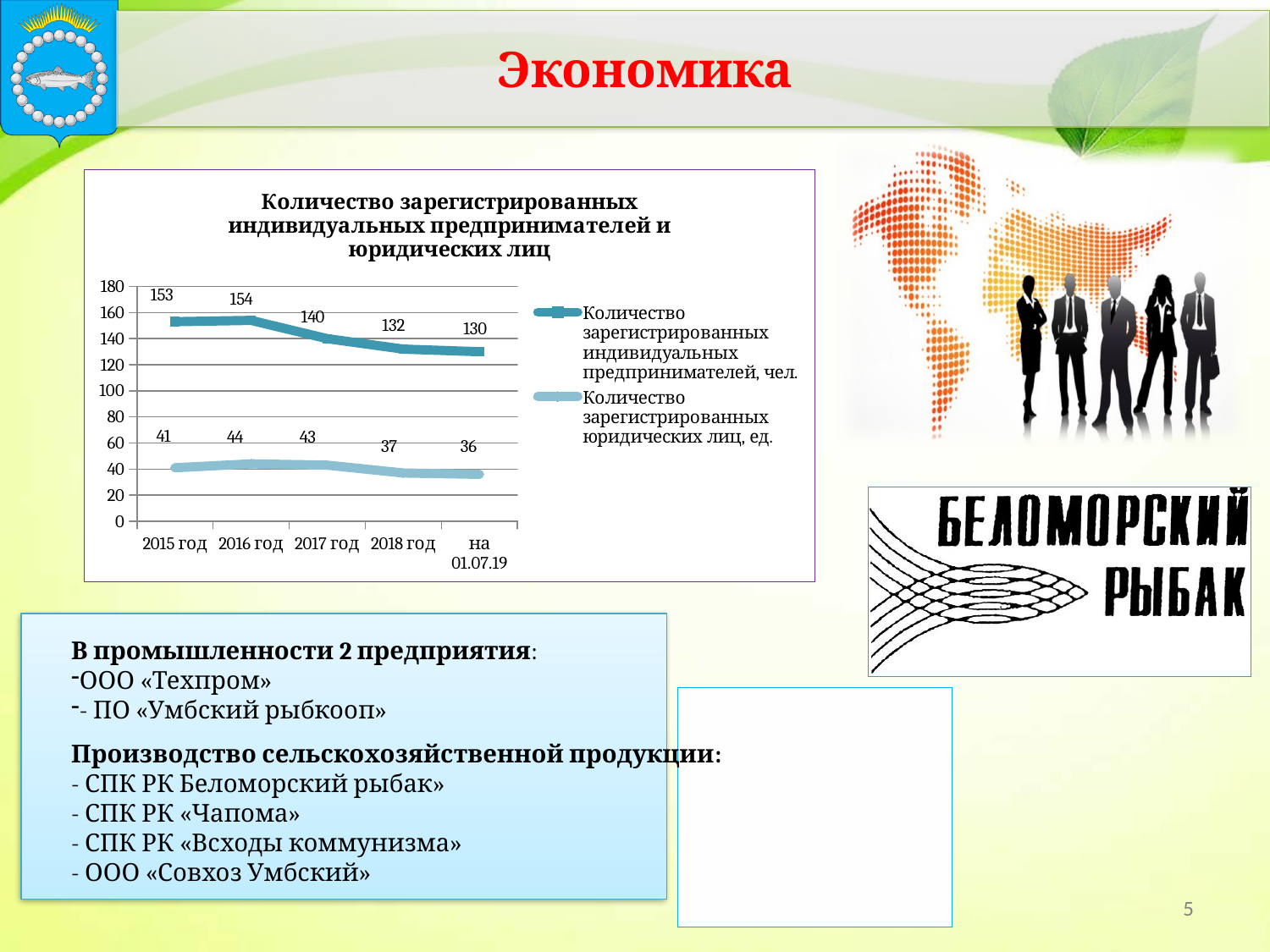
Does the number of registered individual entrepreneurs rise or fall from 2016 год to на 01.07.19? fall In which period is the number of registered individual entrepreneurs highest? 2016 год What type of chart is shown on the slide? line chart How many time periods are shown on the x axis of the chart? 5 What is the number of registered individual entrepreneurs as of на 01.07.19? 130 Which is larger: the number of registered legal entities in 2016 год or in 2018 год? 2016 год What is the title of the chart? Количество зарегистрированных индивидуальных предпринимателей и юридических лиц How many series does the chart legend list? 2 What is the number of registered individual entrepreneurs in 2015 год? 153 What is the number of registered legal entities (юридических лиц) in 2017 год? 43 What is the difference between the number of registered individual entrepreneurs in 2015 год and in 2018 год? 21 In which period is the number of registered legal entities lowest? на 01.07.19